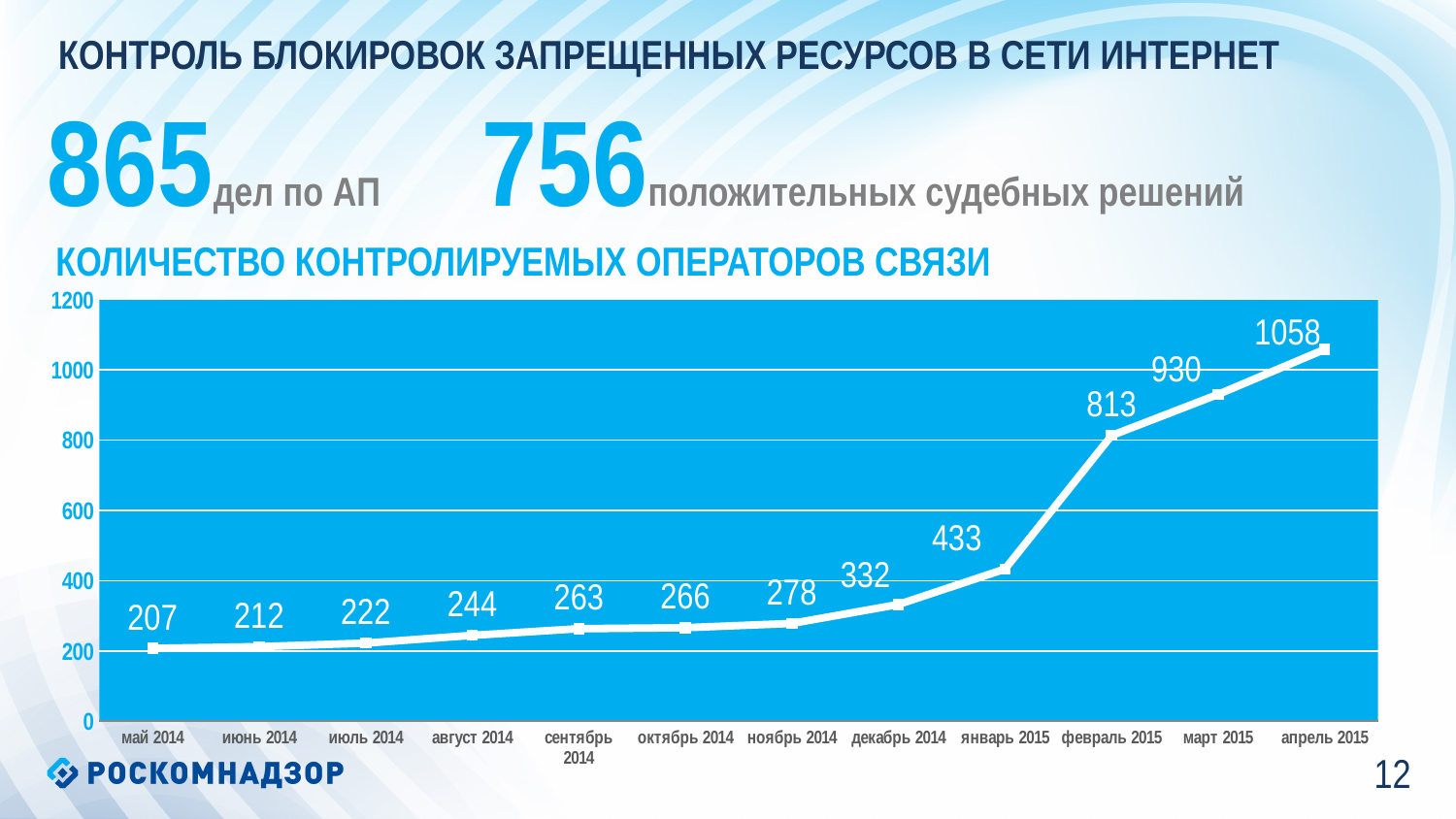
What is the value for сентябрь 2014? 263 What is the value for апрель 2015? 1058 What is the value for январь 2015? 433 What is the difference between the values for февраль 2015 and январь 2015? 380 Which month has the highest value? апрель 2015 How many data points are plotted on the chart? 12 Which month has the lowest value? май 2014 Is the value for декабрь 2014 greater or less than 400? less Do the values rise or fall from май 2014 to апрель 2015? rise Which is larger, the value for март 2015 or the value for февраль 2015? март 2015 What type of chart is shown on the slide? line chart What is the title of the chart? КОЛИЧЕСТВО КОНТРОЛИРУЕМЫХ ОПЕРАТОРОВ СВЯЗИ